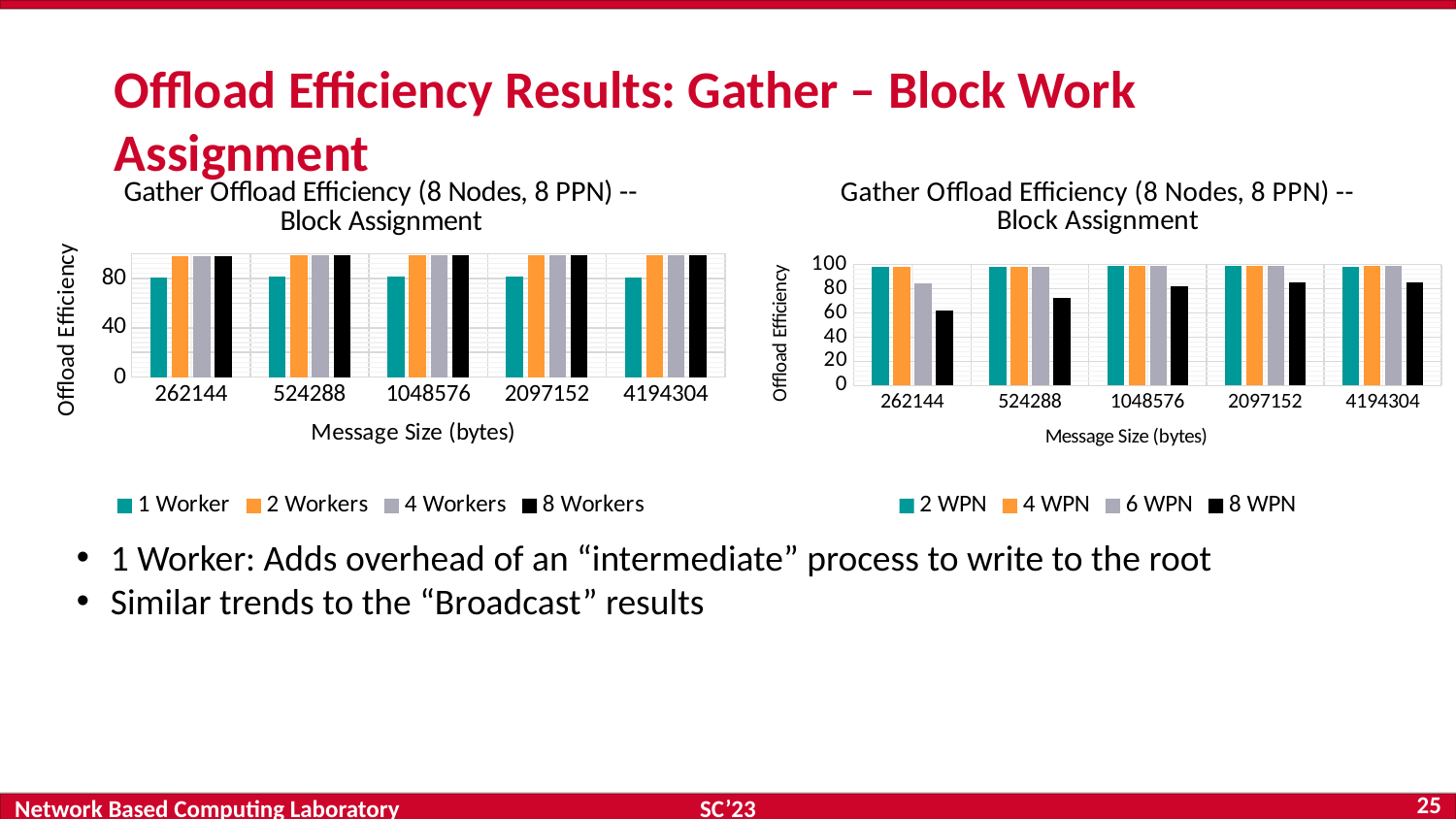
What type of chart is the left chart on the slide? bar chart In the right chart, do the values for 8 WPN generally rise or fall as message size increases along the x axis? rise In the left chart, is the value for 1 Worker at message size 262144 greater or less than 40? greater In the right chart, at message size 262144, which is larger: the value for 2 WPN or the value for 8 WPN? 2 WPN How many series does the legend of the left chart list? 4 In the right chart, is the value for 8 WPN at message size 262144 greater or less than 80? less In the right chart, is the value for 8 WPN at message size 524288 greater or less than 80? less How many message size categories are shown on the x axis of the right chart? 5 In the right chart, which series has the lowest value at message size 262144? 8 WPN What is the x-axis title of the left chart? Message Size (bytes) How many series does the legend of the right chart list? 4